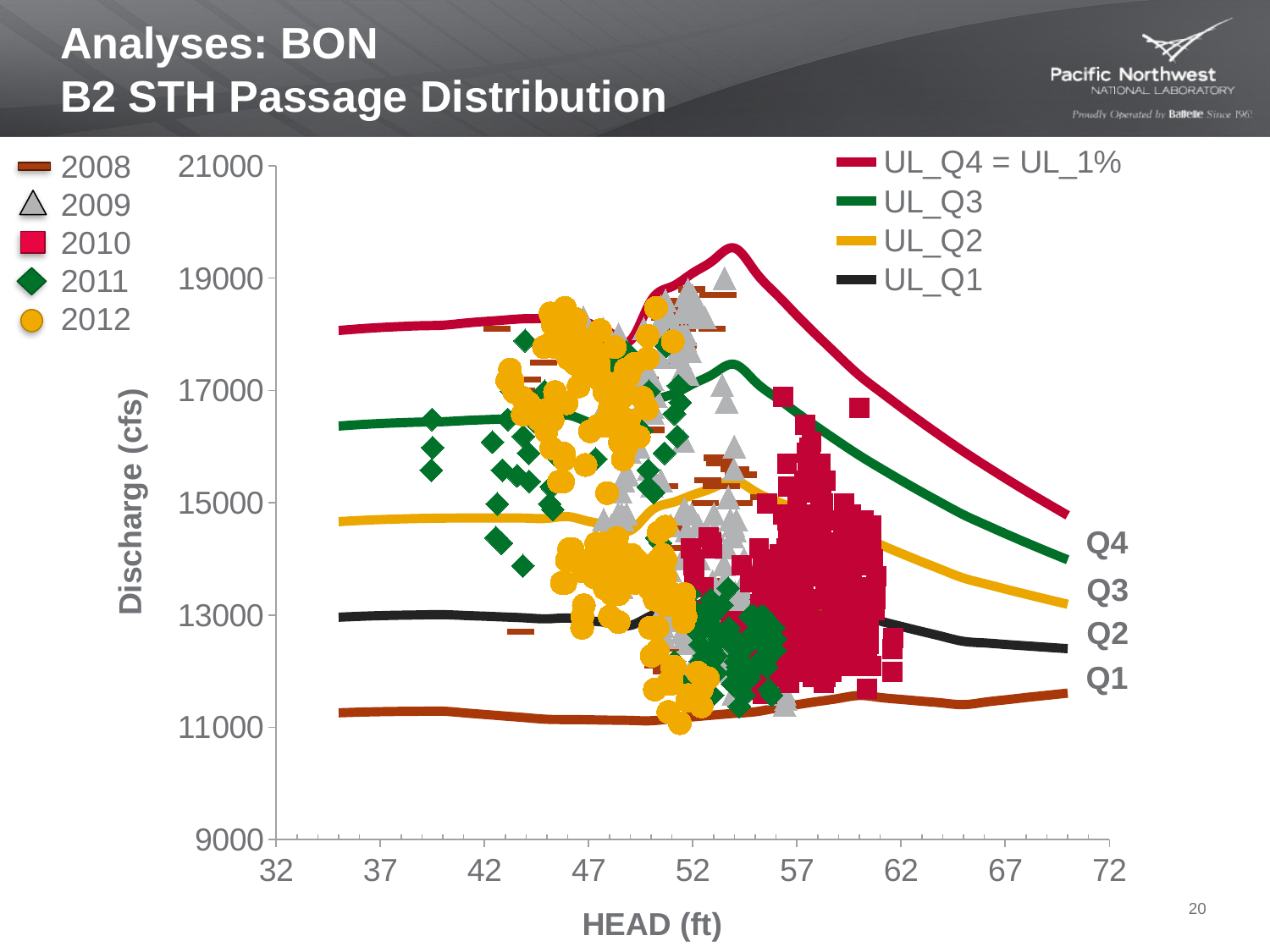
How many entries does the legend list in total (years plus UL lines)? 9 What kind of chart is shown on the slide? scatter chart Is the UL_Q1 line at a head of 37 ft greater or less than 15000? less At a head of 42 ft, which line is higher, UL_Q4 or UL_Q1? UL_Q4 Which UL line is the lowest on the chart? UL_Q1 How many UL lines (UL_Q1 to UL_Q4) are plotted? 4 Which UL line is the highest on the chart? UL_Q4 = UL_1% How many year series (2008–2012) are plotted as markers? 5 Is the UL_Q3 line at a head of 67 ft greater or less than 15000? less Is the UL_Q4 line at a head of 37 ft greater or less than 17000? greater Does the UL_Q4 line rise or fall as head increases from 55 ft to 70 ft? fall What is the title of the x axis? HEAD (ft)